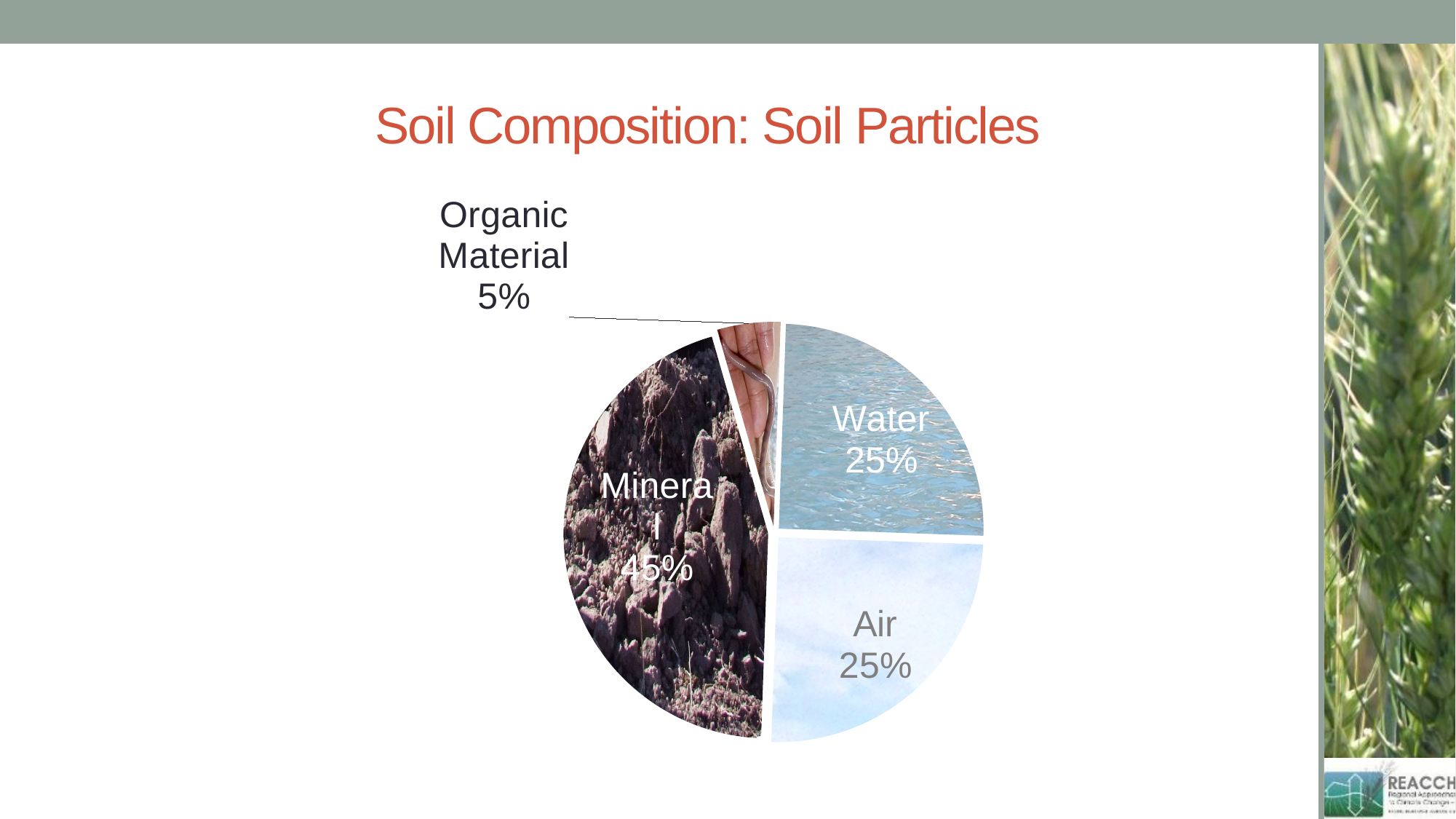
Which is larger, the Mineral slice or the Air slice? Mineral What is the title of the slide containing the pie chart? Soil Composition: Soil Particles What is the difference between the Air share and the Organic Material share? 20% What percentage of the pie is Organic Material? 5% What percentage of the pie is Air? 25% What kind of chart is shown on the slide? pie chart Which slice of the pie is the smallest? Organic Material Which slice of the pie is the largest? Mineral What percentage of the pie is Water? 25% What percentage of the pie is Mineral? 45% How many slices does the pie chart have? 4 What is the difference between the Mineral share and the Water share? 20%